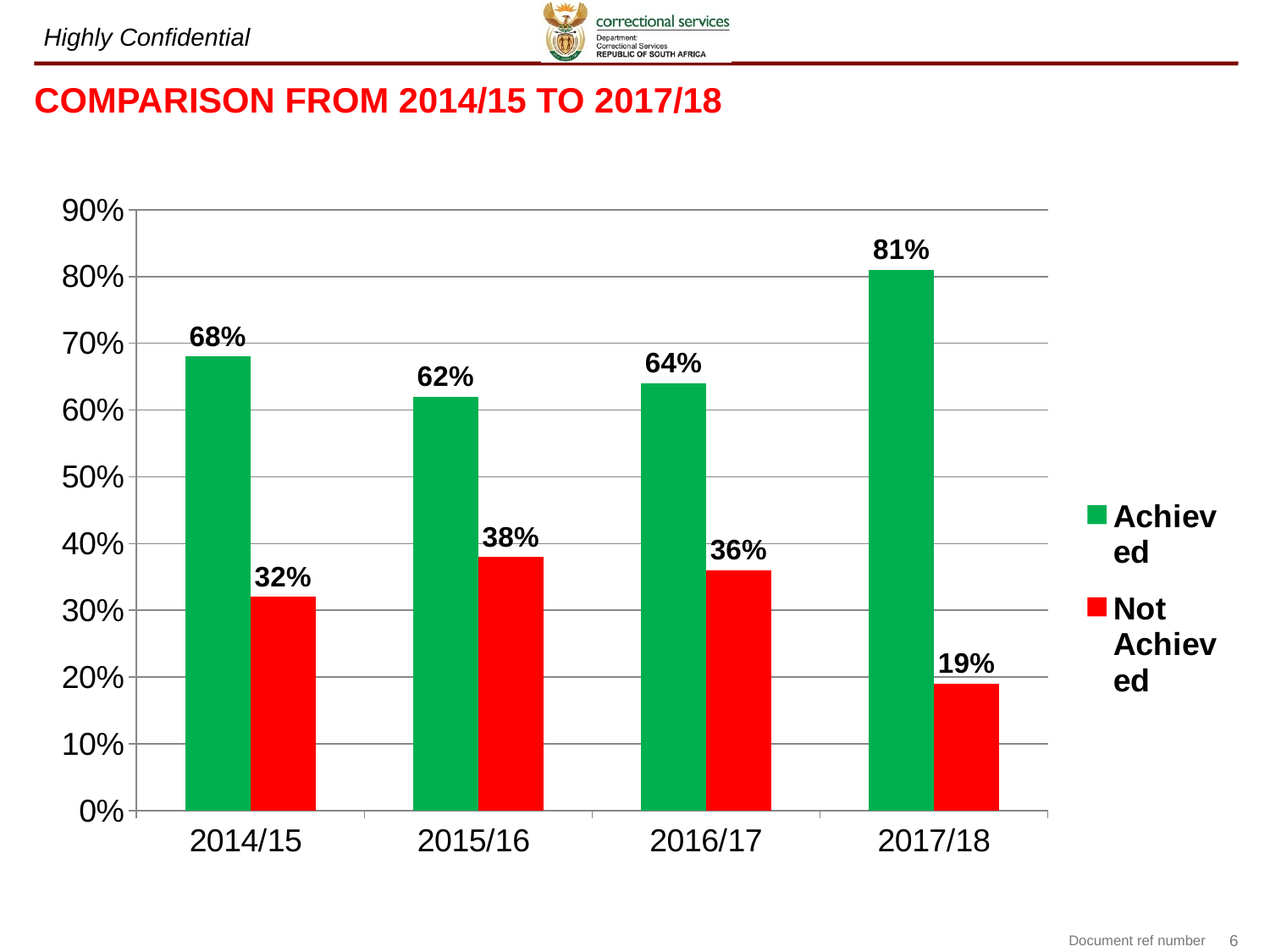
How many series does the legend list? 2 What is the Not Achieved value for 2015/16? 38% What kind of chart is shown on the slide? Bar chart What is the Achieved value for 2014/15? 68% What is the difference between the Achieved values for 2017/18 and 2016/17? 17% What is the Achieved value for 2017/18? 81% What colour represents the Not Achieved series? Red Which is larger: the Not Achieved value for 2015/16 or for 2016/17? 2015/16 Which year has the lowest Achieved value? 2015/16 Which year has the lowest Not Achieved value? 2017/18 Which year has the highest Achieved value? 2017/18 How many years are shown on the x axis? 4